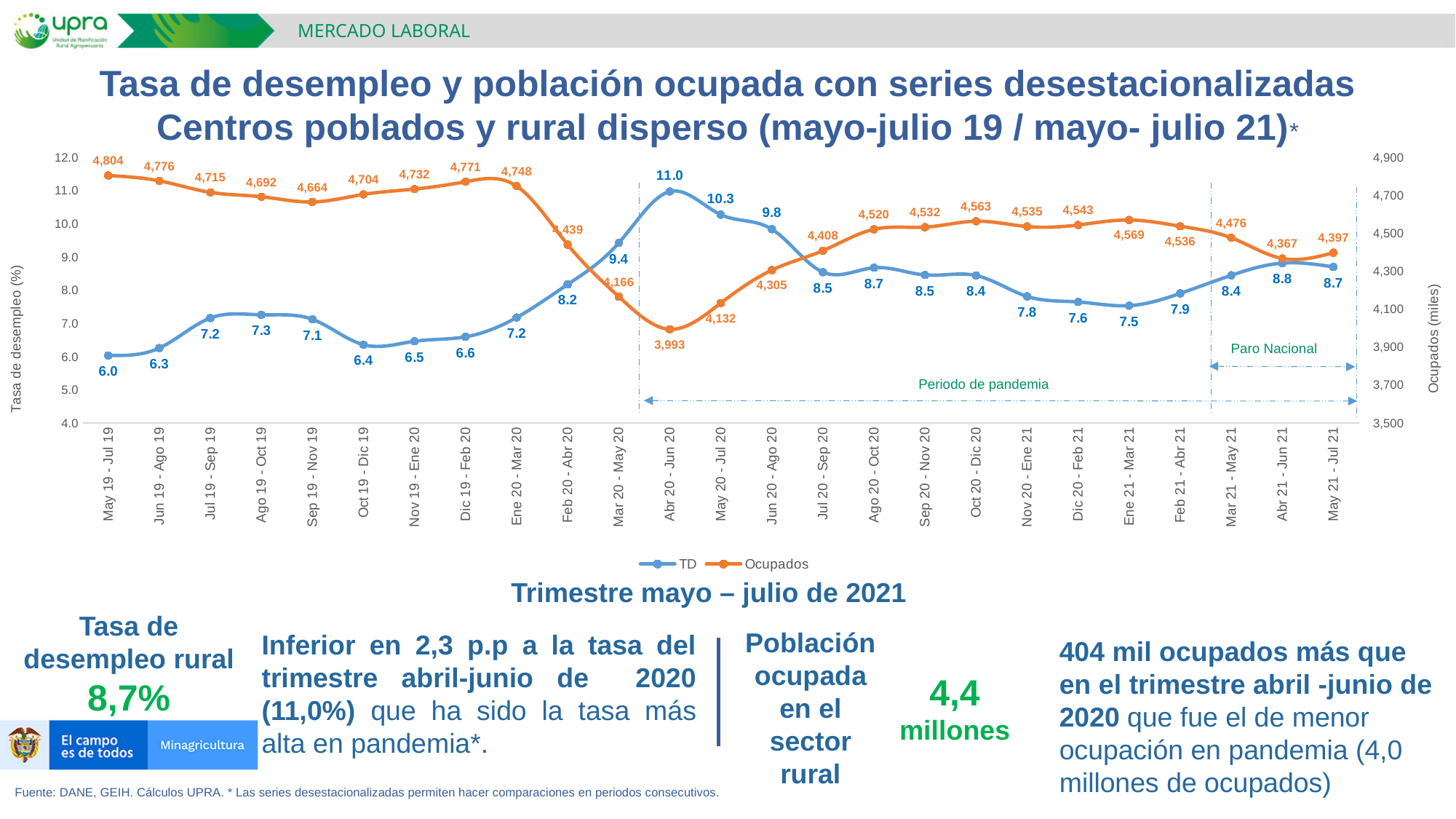
Which is larger, the Ocupados value for Oct 20 - Dic 20 or for Abr 21 - Jun 21? Oct 20 - Dic 20 What is the Ocupados value for the May 19 - Jul 19 quarter? 4,804 In which quarter does the TD series reach its highest value? Abr 20 - Jun 20 By how much does the Ocupados value for May 21 - Jul 21 exceed the Ocupados value for Abr 20 - Jun 20? 404 How many quarters (data points) are plotted along the x axis? 25 What is the lowest TD value shown on the chart? 6.0 What is the difference between the TD value for Abr 20 - Jun 20 and the TD value for May 21 - Jul 21? 2.3 What type of chart is shown on the slide? Line chart What is the Ocupados value for the May 21 - Jul 21 quarter? 4,397 How many series does the chart legend list? 2 What is the TD (unemployment rate) value for the Abr 20 - Jun 20 quarter? 11.0 In which quarter does the Ocupados series reach its lowest value? Abr 20 - Jun 20